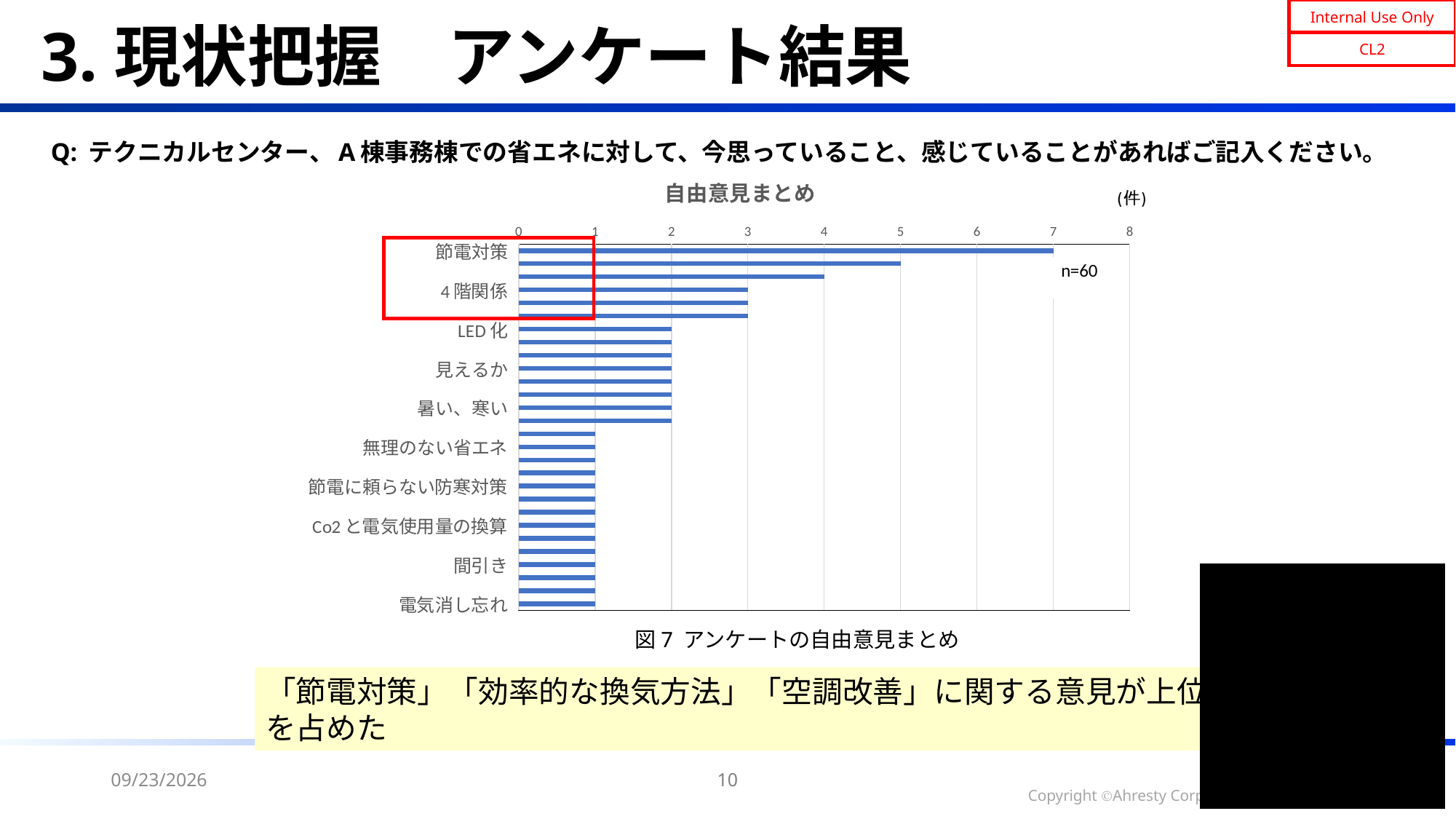
Is the value for 節電対策 greater or less than 5? greater What kind of chart is shown on the slide? bar chart Which is larger, the value for 見えるか or the value for 間引き? 見えるか What is the value for 4階関係? 3 What is the value for 暑い、寒い? 2 What is the difference between the values for 節電対策 and 4階関係? 4 What is the value for 電気消し忘れ? 1 What is the title of the chart? 自由意見まとめ What sample size (n) is noted on the chart? n=60 Which category has the highest value in the chart? 節電対策 What is the value for LED化? 2 What is the value for 節電対策? 7